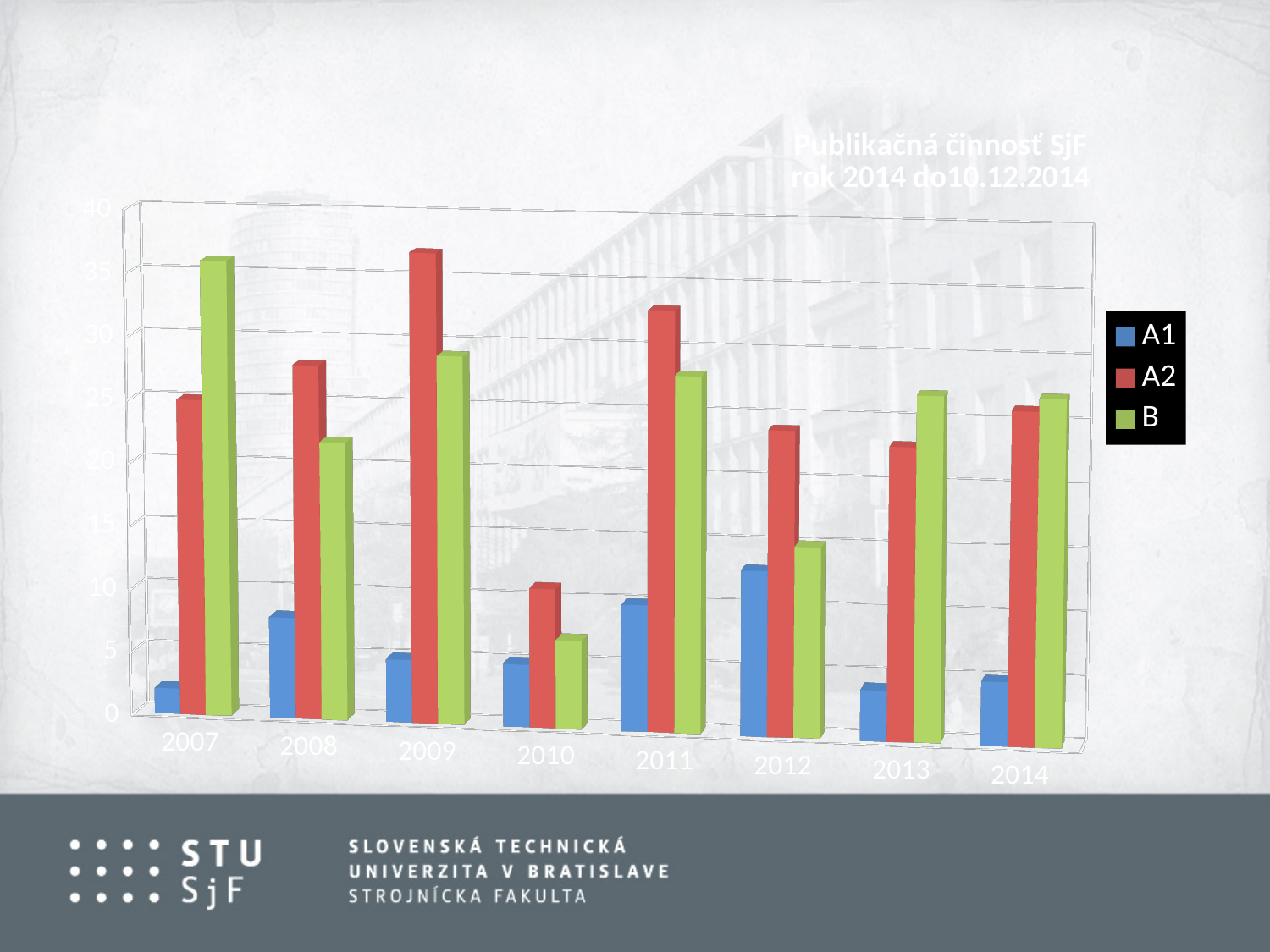
How many years are shown on the x axis? 8 Is the value for A2 in 2009 greater or less than 30? greater In 2007, which series has the larger value, A2 or B? B In 2009, which series has the larger value, A2 or B? A2 Which year has the lowest value for series A2? 2010 Which year has the lowest value for series B? 2010 What are the three series names listed in the legend? A1, A2, B Which year has the highest value for series A2? 2009 What kind of chart is shown on the slide? bar chart Is the value for A2 in 2010 greater or less than 15? less Which year has the highest value for series B? 2007 How many series does the legend list? 3